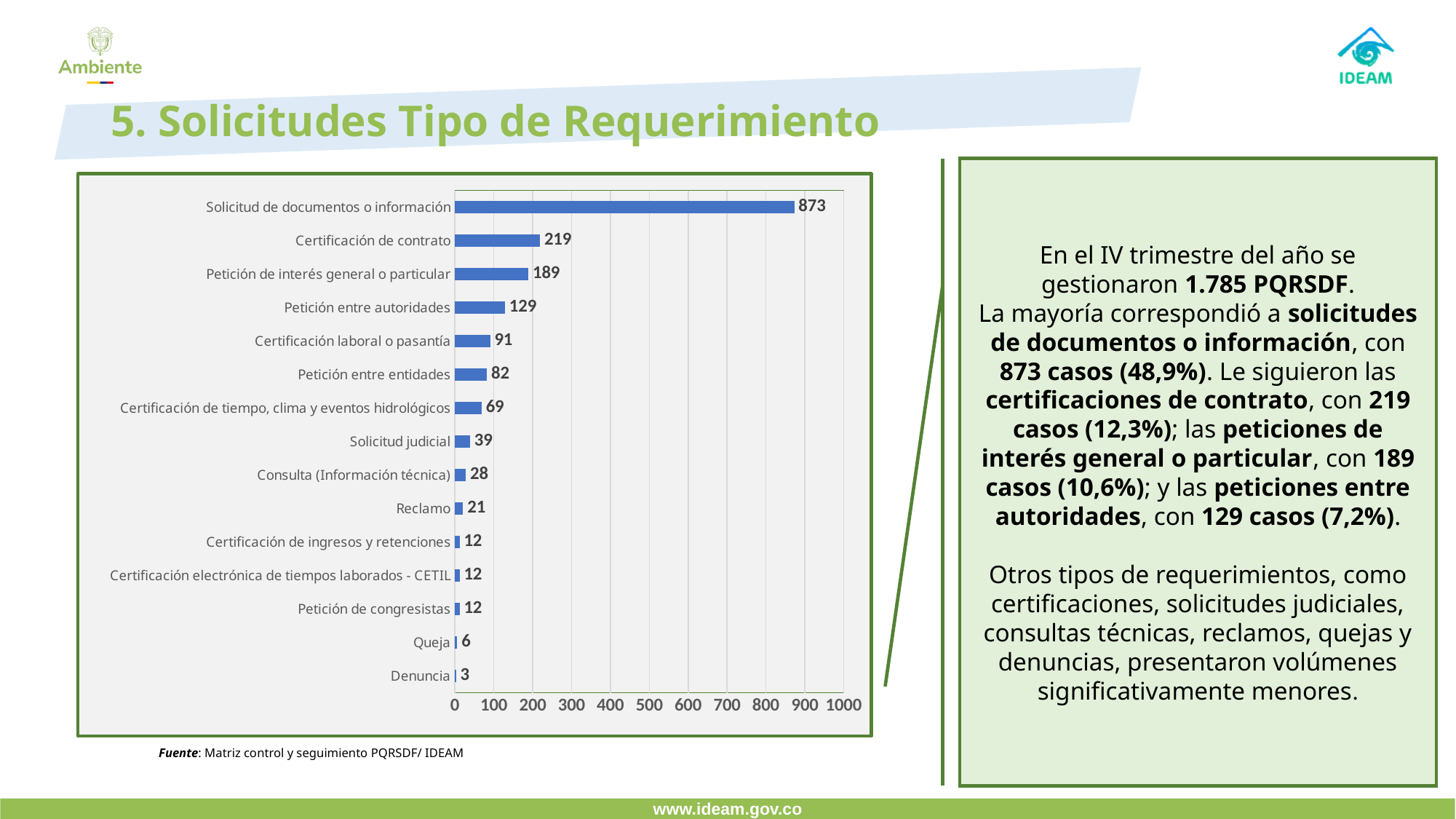
How many categories are shown in the chart? 15 What is the value for Solicitud judicial? 39 What is the difference between the values for Certificación de contrato and Petición de interés general o particular? 30 Which category has the highest value? Solicitud de documentos o información What is the difference between the values for Reclamo and Queja? 15 Which category has the lowest value? Denuncia Is the value for Solicitud de documentos o información greater or less than 800? greater What is the value for Solicitud de documentos o información? 873 What kind of chart is shown on the slide? bar chart Which is larger, the value for Certificación laboral o pasantía or the value for Petición entre entidades? Certificación laboral o pasantía What is the value for Certificación de contrato? 219 What is the value for Petición entre autoridades? 129